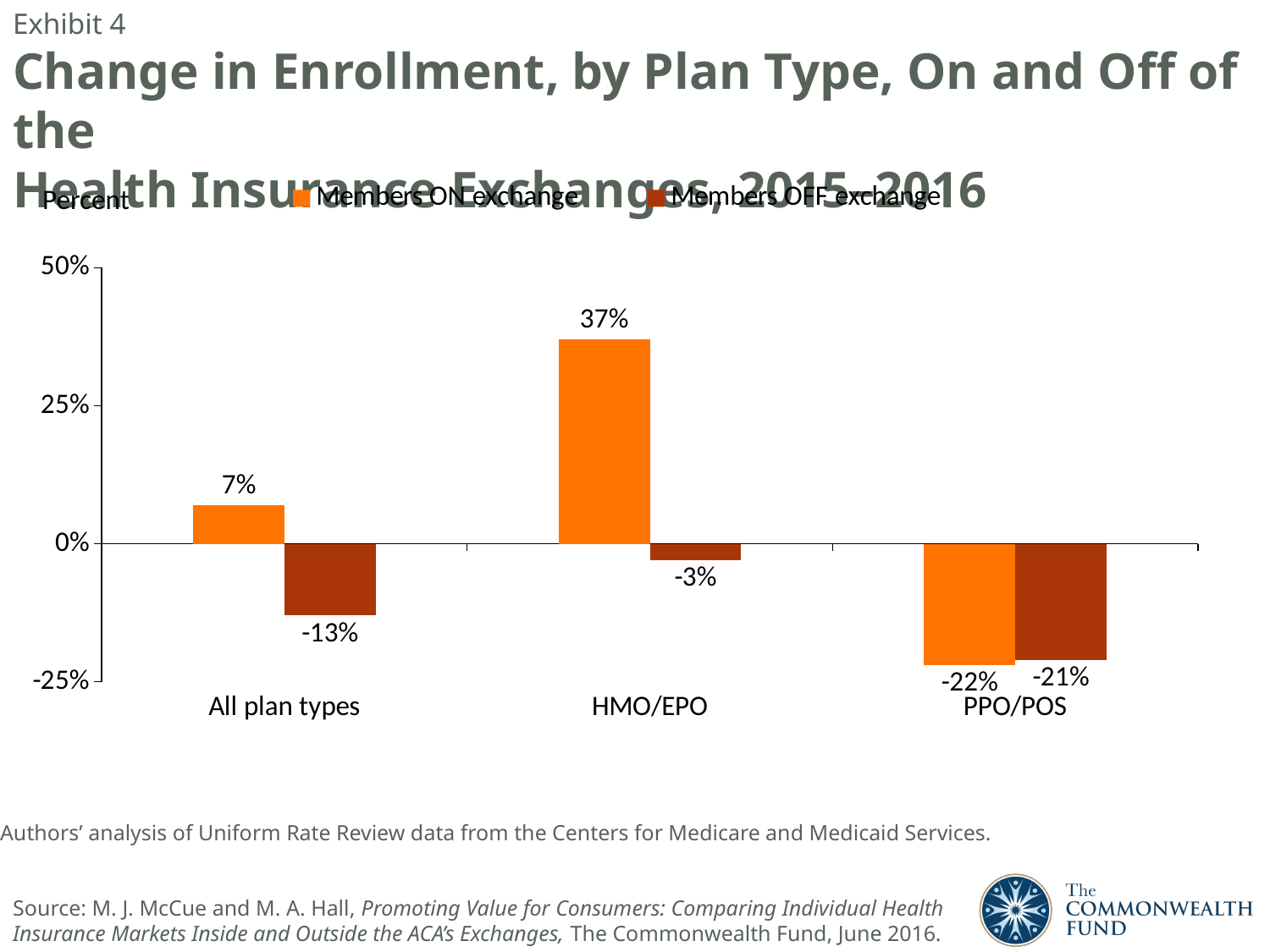
Which plan type has the lowest value for Members OFF exchange? PPO/POS What is the value for Members OFF exchange for All plan types? -13% What is the value for Members OFF exchange for HMO/EPO? -3% How many plan type categories are shown on the x axis? 3 What is the difference between the Members ON exchange and Members OFF exchange values for All plan types? 20 percentage points Is the value for Members ON exchange for HMO/EPO greater or less than 25%? greater What is the value for Members ON exchange for PPO/POS? -22% What kind of chart is shown on the slide? Bar chart Which plan type has the highest value for Members ON exchange? HMO/EPO Which is larger for HMO/EPO: Members ON exchange or Members OFF exchange? Members ON exchange How many series does the legend list? 2 What is the value for Members ON exchange for HMO/EPO? 37%